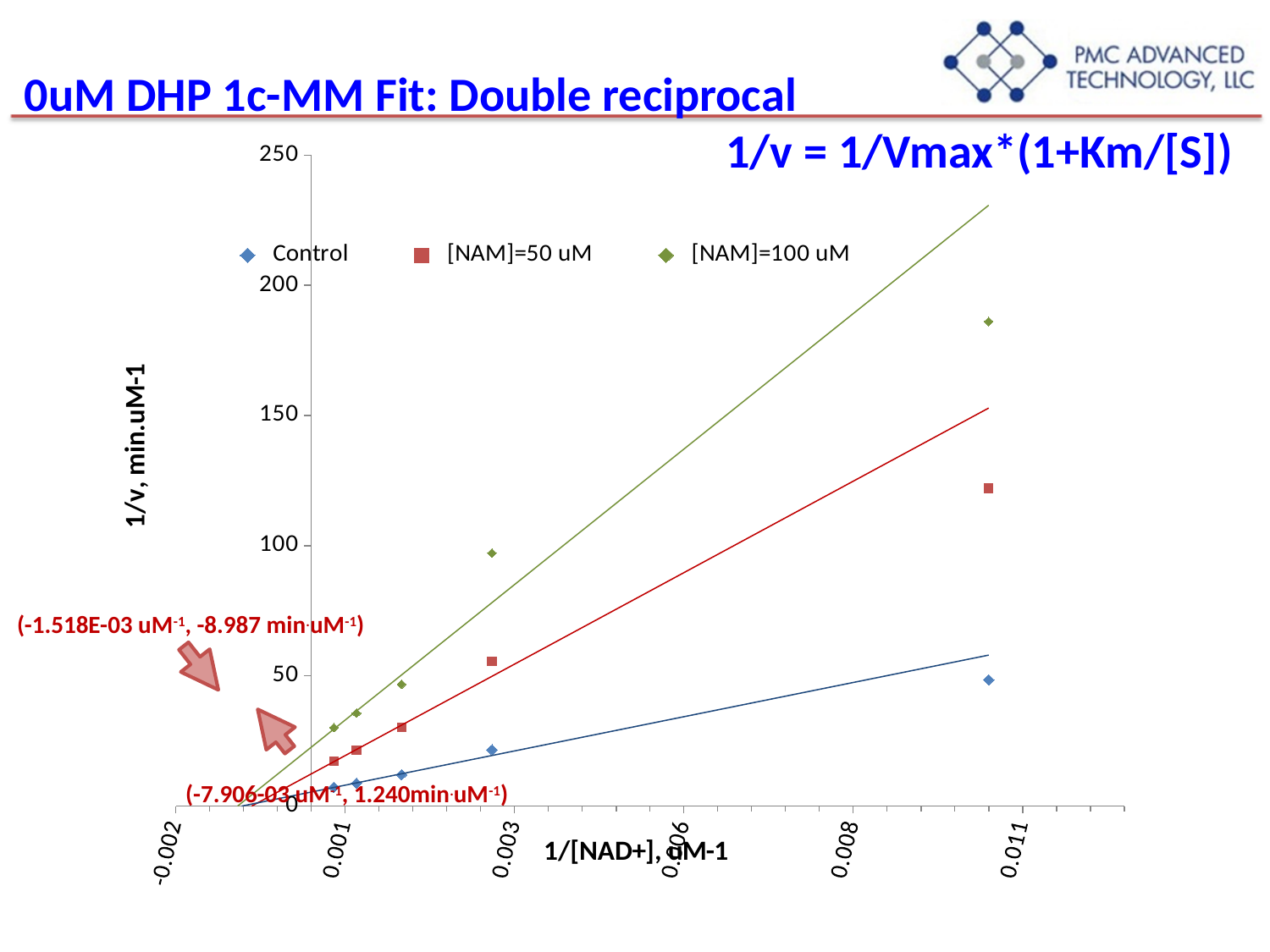
How many series does the legend list? 3 Which series has the highest 1/v value at the largest 1/[NAD+] value plotted? [NAM]=100 uM Which series has the lowest 1/v value at the largest 1/[NAD+] value plotted? Control How many data points are plotted for the Control series? 5 Is the 1/v value for Control at the largest 1/[NAD+] value greater or less than 100? less What kind of chart is shown on the slide? scatter chart Do the 1/v values rise or fall as 1/[NAD+] increases? rise What is the label of the y axis? 1/v, min.uM-1 Is the 1/v value for [NAM]=100 uM at the largest 1/[NAD+] value greater or less than 150? greater What is the title of the chart? 0uM DHP 1c-MM Fit: Double reciprocal At the largest 1/[NAD+] value plotted, which is larger: the 1/v value for [NAM]=50 uM or for Control? [NAM]=50 uM Is the 1/v value for [NAM]=50 uM at the largest 1/[NAD+] value greater or less than 100? greater